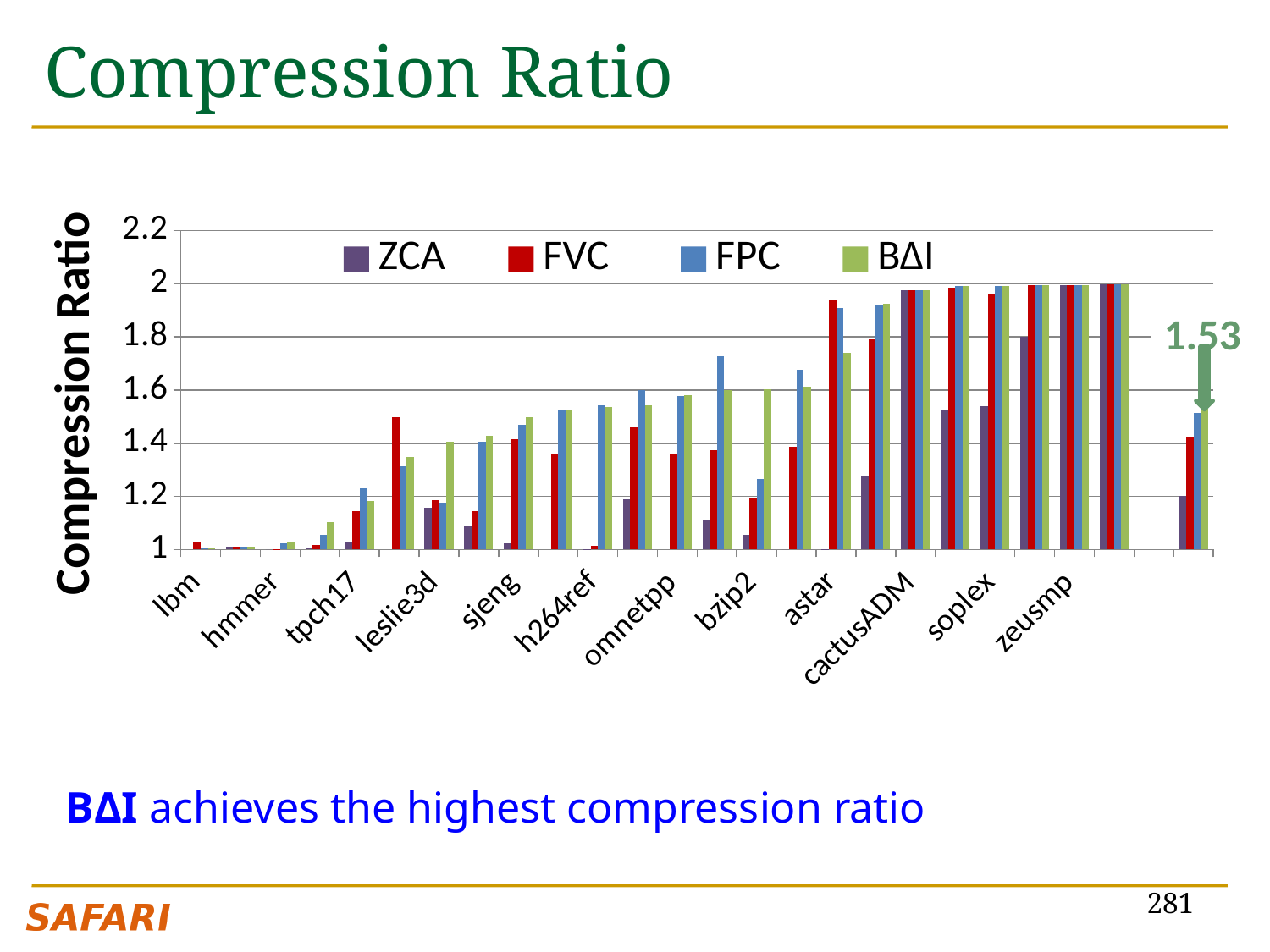
How many series does the legend list? 4 Is the annotated value 1.53 greater or less than 1.4? greater What is the title of the chart? Compression Ratio What value is annotated with the arrow at the right end of the chart? 1.53 In the rightmost group of bars (the one annotated 1.53), is the ZCA value greater or less than 1.4? less What are the series names listed in the legend? ZCA, FVC, FPC, BΔI What kind of chart is shown on the slide? bar chart What is the highest tick value shown on the y axis? 2.2 What is the lowest tick value shown on the y axis? 1 Which series does the annotated value 1.53 belong to? BΔI